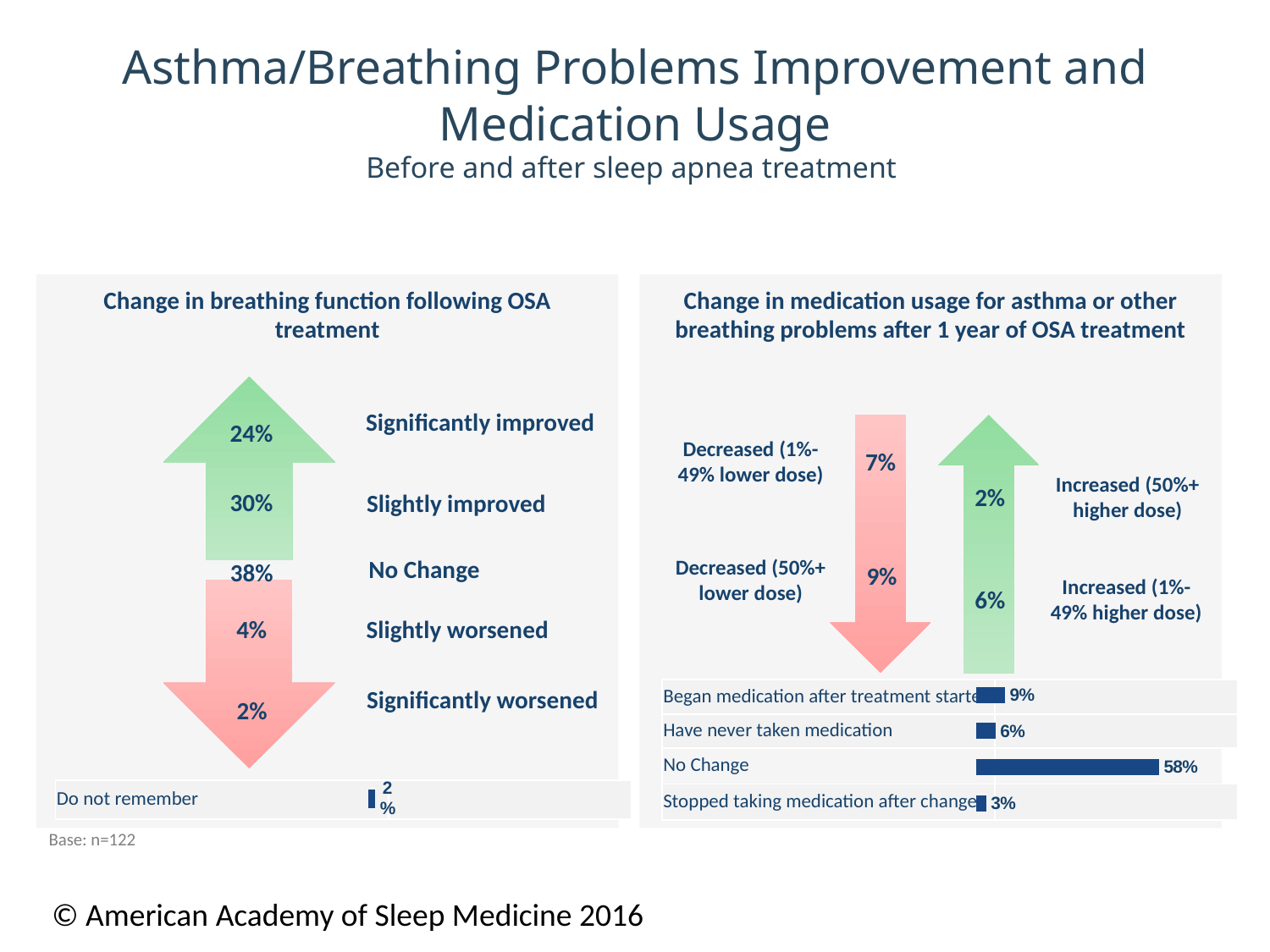
In the right chart (Change in medication usage), what percentage reported 'Increased (50%+ higher dose)'? 2% In the right chart (Change in medication usage), what percentage reported 'Decreased (50%+ lower dose)'? 9% In the left chart (Change in breathing function following OSA treatment), what is the difference between 'Slightly improved' and 'Slightly worsened'? 26 percentage points In the right chart (Change in medication usage), what is the difference between 'Decreased (50%+ lower dose)' and 'Decreased (1%-49% lower dose)'? 2 percentage points In the left chart (Change in breathing function following OSA treatment), which response category has the highest percentage? No Change In the left chart (Change in breathing function following OSA treatment), what percentage reported 'No Change'? 38% In the right chart (Change in medication usage), which is larger: 'Have never taken medication' or 'Stopped taking medication after change'? Have never taken medication In the left chart (Change in breathing function following OSA treatment), what percentage reported 'Significantly improved'? 24% In the left chart (Change in breathing function following OSA treatment), what percentage is shown for 'Do not remember'? 2% In the right chart (Change in medication usage), what percentage reported 'No Change'? 58% In the left chart (Change in breathing function following OSA treatment), what percentage reported 'Significantly worsened'? 2% In the right chart (Change in medication usage), how many categories are shown in the bar chart at the bottom of the panel? 4